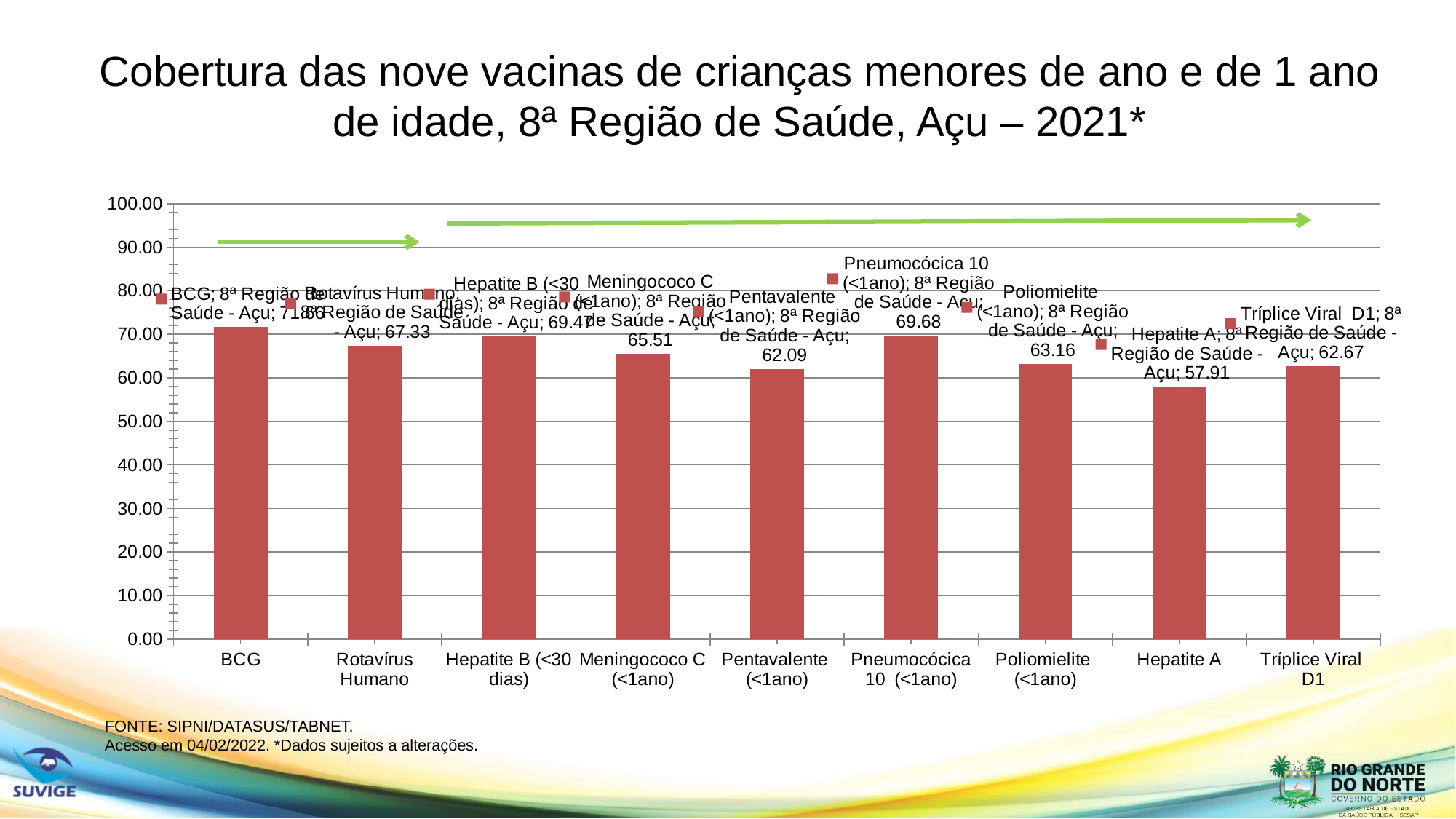
What is the difference between the values for Rotavírus Humano and Hepatite A? 9.42 What is the value for Tríplice Viral D1? 62.67 What kind of chart is shown on the slide? bar chart Which vaccine has the highest coverage value? BCG What is the value for Rotavírus Humano? 67.33 What is the difference between the values for Poliomielite (<1ano) and Pentavalente (<1ano)? 1.07 Is the value for BCG greater or less than 70? greater What is the value for Hepatite A? 57.91 How many vaccines are shown on the x axis? 9 Which is larger, the value for Meningococo C (<1ano) or the value for Poliomielite (<1ano)? Meningococo C (<1ano) Which vaccine has the lowest coverage value? Hepatite A What is the value for Pneumocócica 10 (<1ano)? 69.68